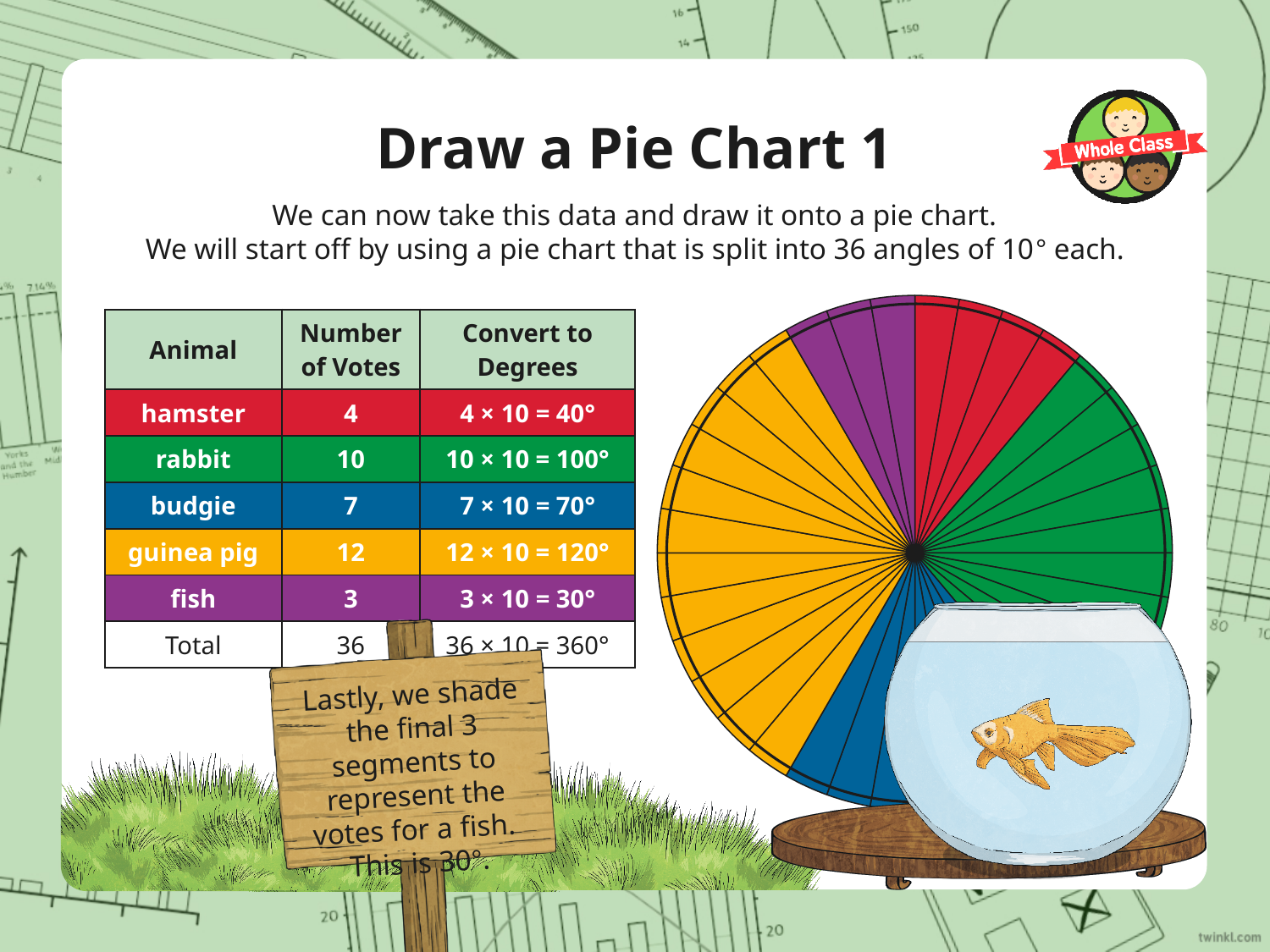
How many degrees does the guinea pig segment take up in the pie chart? 120° How many 10° segments is the pie chart split into? 36 Which animal has the largest segment in the pie chart? guinea pig What is the difference in votes between the guinea pig and the hamster? 8 How many animals (categories) are shown in the pie chart? 5 How many degrees does the fish segment represent? 30° How many votes does the rabbit have? 10 What kind of chart is shown on the slide? pie chart What is the total number of votes represented in the pie chart? 36 What colour is used for the budgie segment in the pie chart? blue Which has more votes, the rabbit or the budgie? rabbit Which animal has the smallest segment in the pie chart? fish